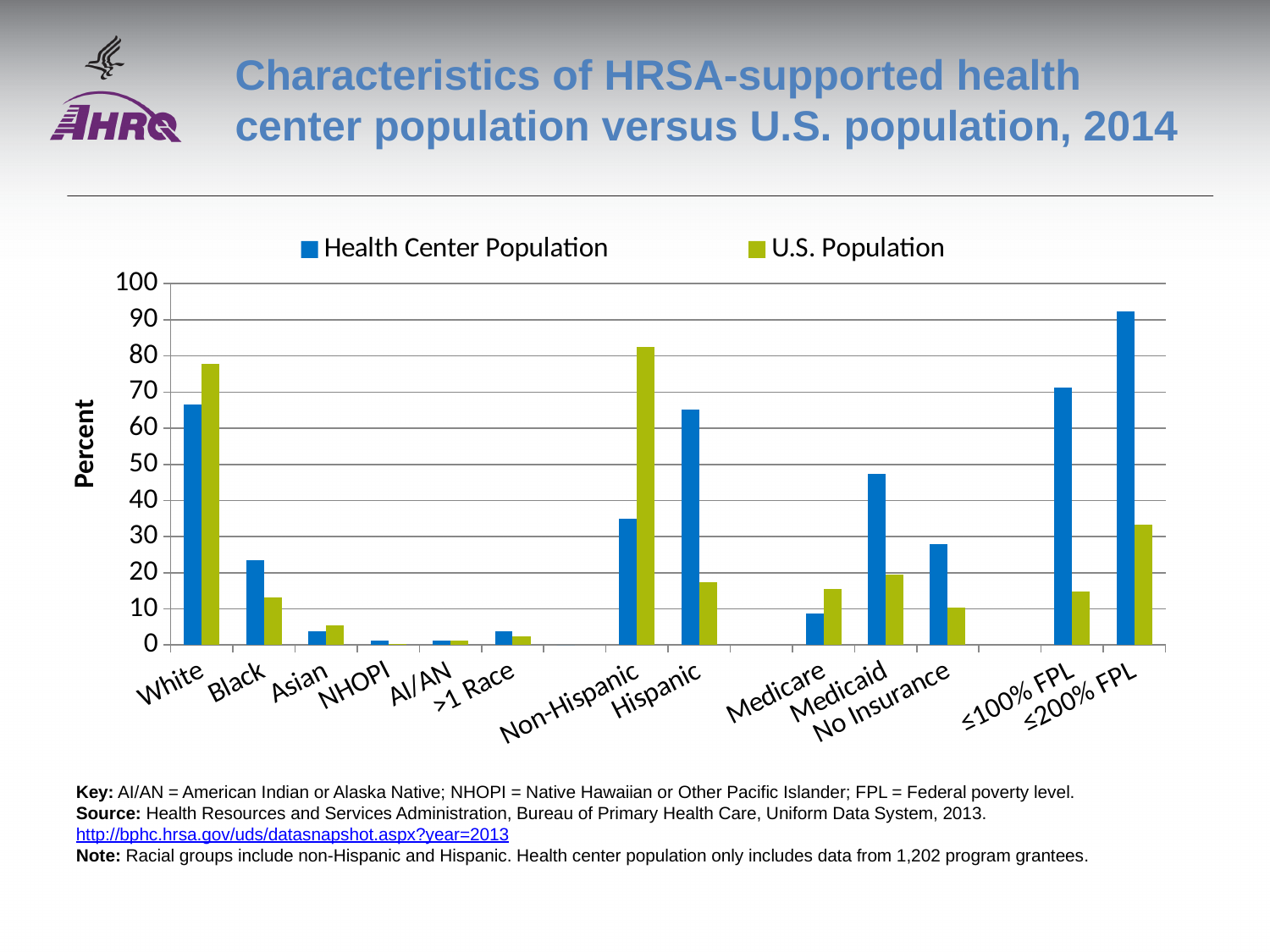
What kind of chart is shown on the slide? bar chart What is the label on the y axis? Percent Is the Health Center Population value for ≤200% FPL greater or less than 90? greater For White, which series has the larger value, Health Center Population or U.S. Population? U.S. Population Is the U.S. Population value for Non-Hispanic greater or less than 80? greater Which category has the highest value for the U.S. Population series? Non-Hispanic How many categories are shown along the x axis? 13 How many series does the legend list? 2 Which category has the highest value for the Health Center Population series? ≤200% FPL For Hispanic, which series has the larger value, Health Center Population or U.S. Population? Health Center Population Is the Health Center Population value for Medicaid greater or less than 40? greater